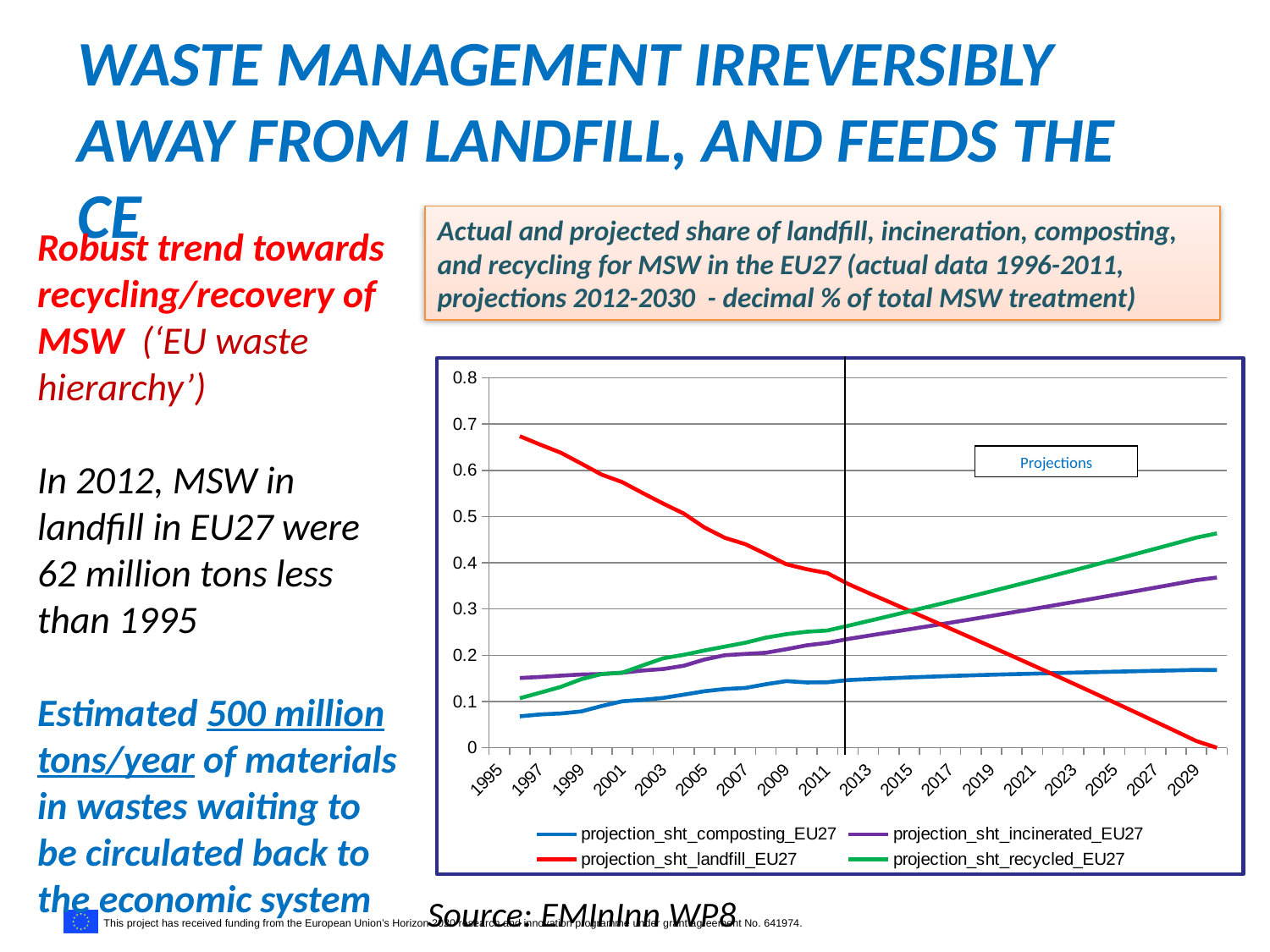
Does the projection_sht_landfill_EU27 series rise or fall from 1997 to 2029? fall Is the value for projection_sht_landfill_EU27 in 2029 greater or less than 0.1? less Does the projection_sht_recycled_EU27 series rise or fall from 1997 to 2029? rise Is the value for projection_sht_composting_EU27 in 2029 greater or less than 0.2? less How many series does the chart legend list? 4 Which series has the lowest value in 1997? projection_sht_composting_EU27 Which series is drawn in red on the chart? projection_sht_landfill_EU27 Is the value for projection_sht_landfill_EU27 in 1997 greater or less than 0.6? greater What kind of chart is shown on the slide? line chart Which series has the highest value in 1997? projection_sht_landfill_EU27 In 2029, which is larger: projection_sht_recycled_EU27 or projection_sht_incinerated_EU27? projection_sht_recycled_EU27